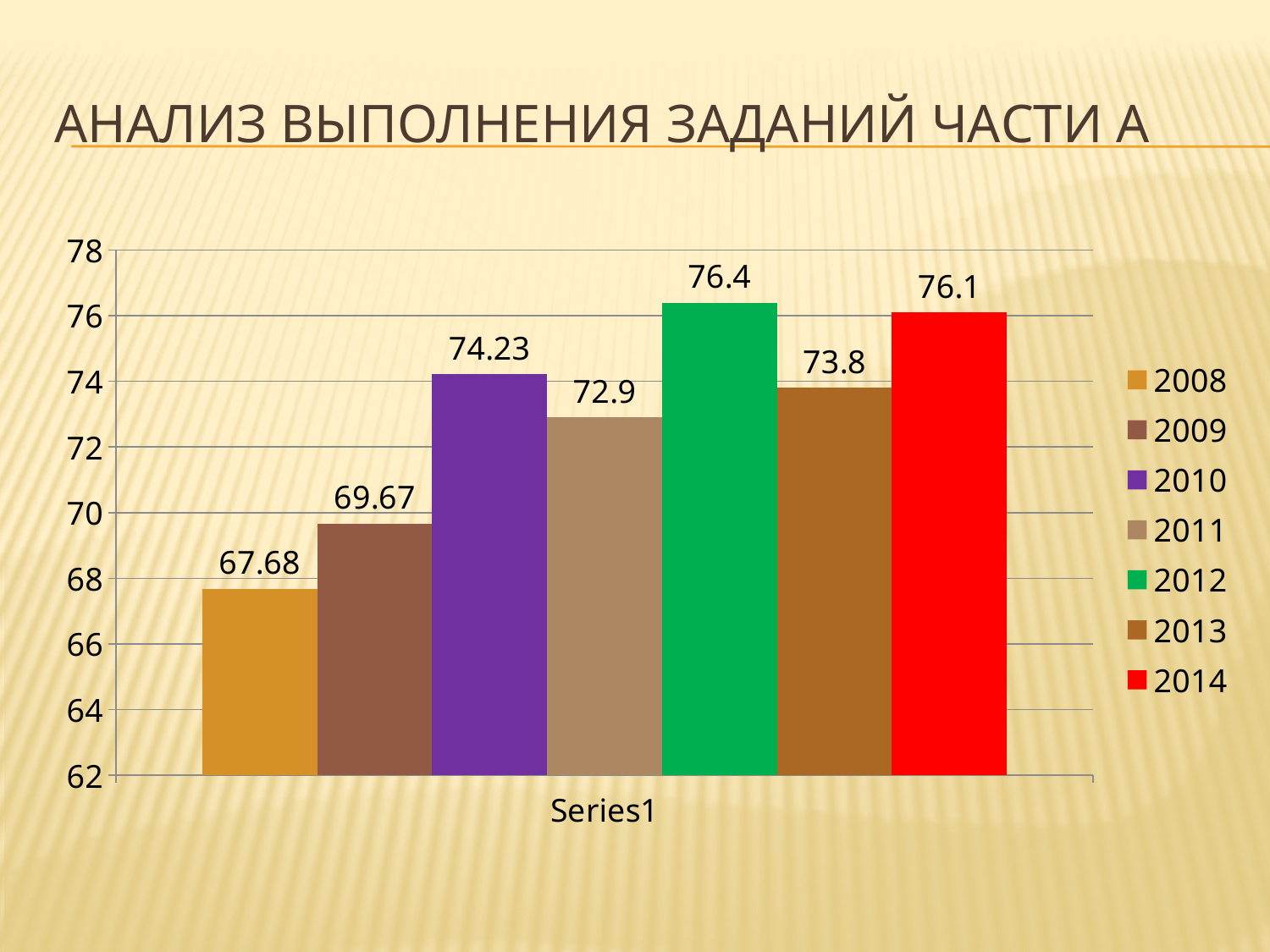
Which year has the lowest value? 2008 What kind of chart is shown on the slide? bar chart What colour is the bar for 2014? red What is the value for 2011? 72.9 What is the difference between the values for 2009 and 2008? 1.99 What is the value for 2012? 76.4 Is the value for 2013 greater or less than 74? less Which year has the highest value? 2012 How many years are shown in the legend? 7 What is the value for 2008? 67.68 Which is larger, the value for 2010 or the value for 2011? 2010 What is the difference between the values for 2014 and 2013? 2.3